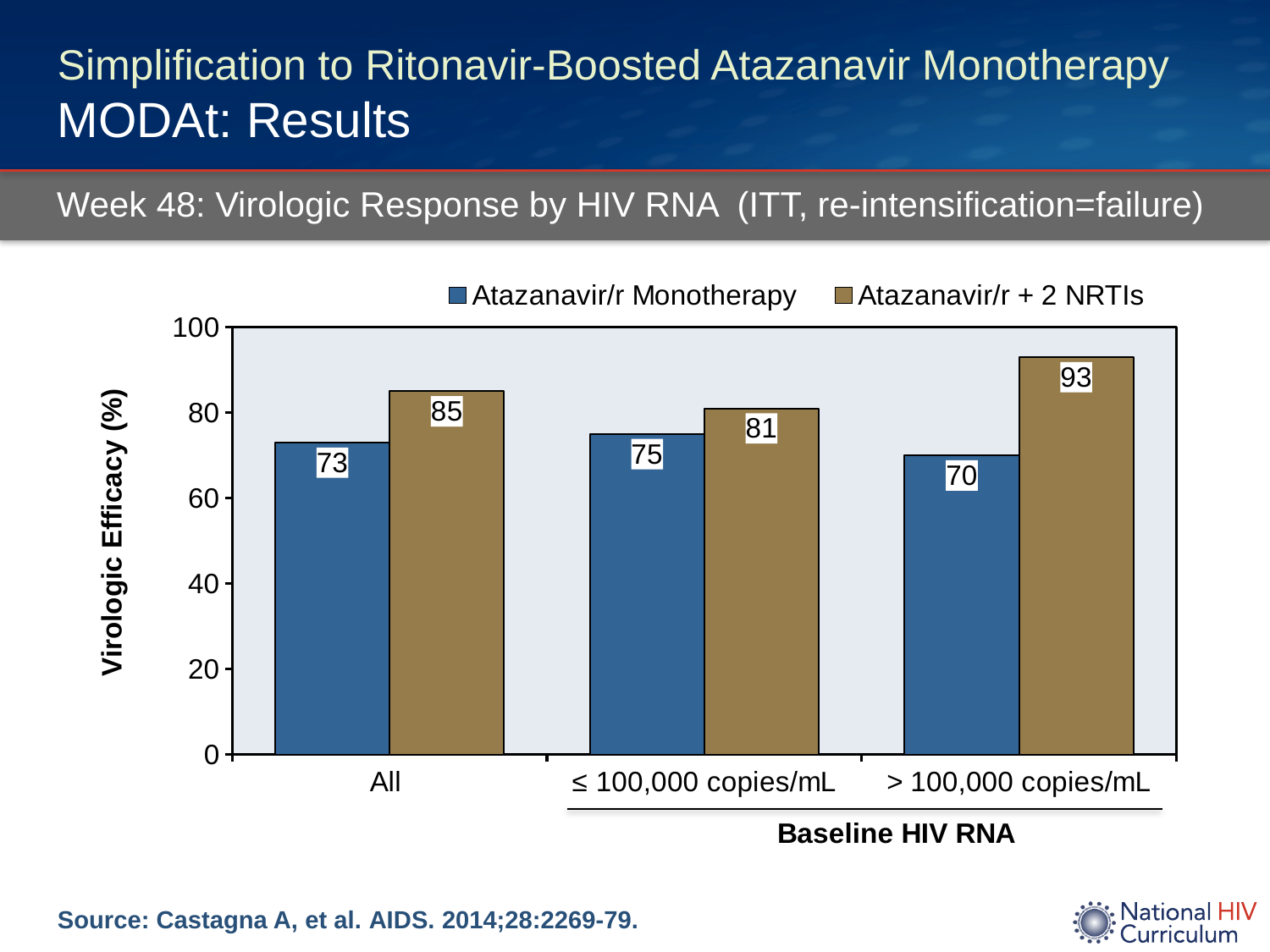
Which category has the lowest value for Atazanavir/r Monotherapy? > 100,000 copies/mL What is the virologic efficacy for Atazanavir/r + 2 NRTIs in the > 100,000 copies/mL group? 93 Which baseline HIV RNA category has the highest value for Atazanavir/r + 2 NRTIs? > 100,000 copies/mL What kind of chart is shown on the slide? Bar chart What is the virologic efficacy for Atazanavir/r + 2 NRTIs in the ≤ 100,000 copies/mL group? 81 In the ≤ 100,000 copies/mL group, which series has the larger value? Atazanavir/r + 2 NRTIs How many categories are shown on the x axis? 3 How many series does the legend list? 2 What is the virologic efficacy for Atazanavir/r Monotherapy in the All group? 73 What is the difference between Atazanavir/r + 2 NRTIs and Atazanavir/r Monotherapy in the > 100,000 copies/mL group? 23 What is the label of the y axis? Virologic Efficacy (%) What is the difference between Atazanavir/r + 2 NRTIs and Atazanavir/r Monotherapy in the All group? 12